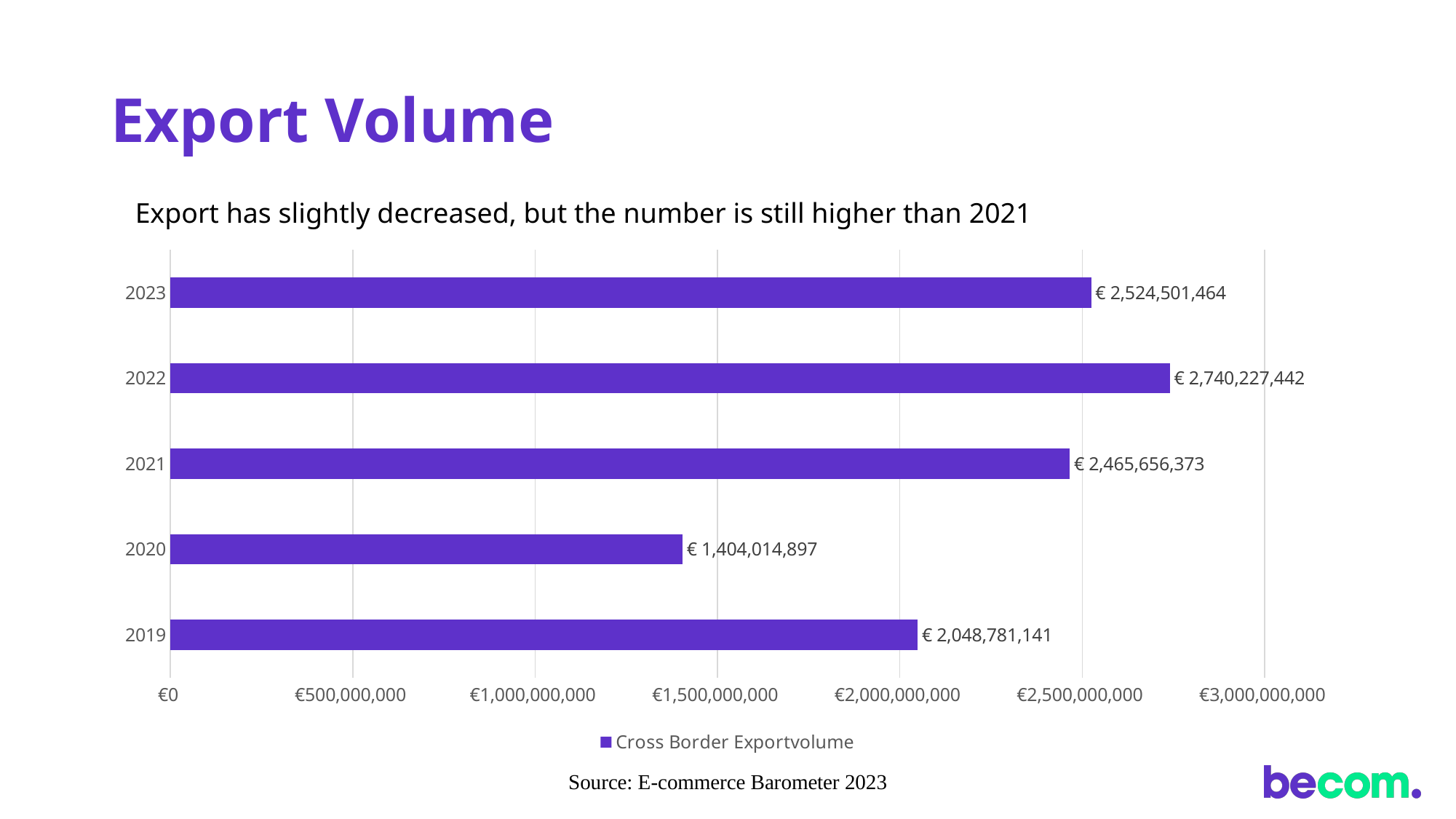
By how much did the Cross Border Exportvolume decrease from 2022 to 2023? € 215,725,978 What type of chart is shown on the slide? Bar chart What is the difference between the Cross Border Exportvolume in 2023 and in 2021? € 58,845,091 What is the Cross Border Exportvolume for 2019? € 2,048,781,141 How many years are shown in the chart? 5 Is the Cross Border Exportvolume for 2021 greater or less than €2,000,000,000? greater What is the name of the series shown in the legend? Cross Border Exportvolume Which year has a larger Cross Border Exportvolume, 2019 or 2020? 2019 What is the Cross Border Exportvolume for 2020? € 1,404,014,897 Which year has the highest Cross Border Exportvolume? 2022 What is the Cross Border Exportvolume for 2023? € 2,524,501,464 Which year has the lowest Cross Border Exportvolume? 2020